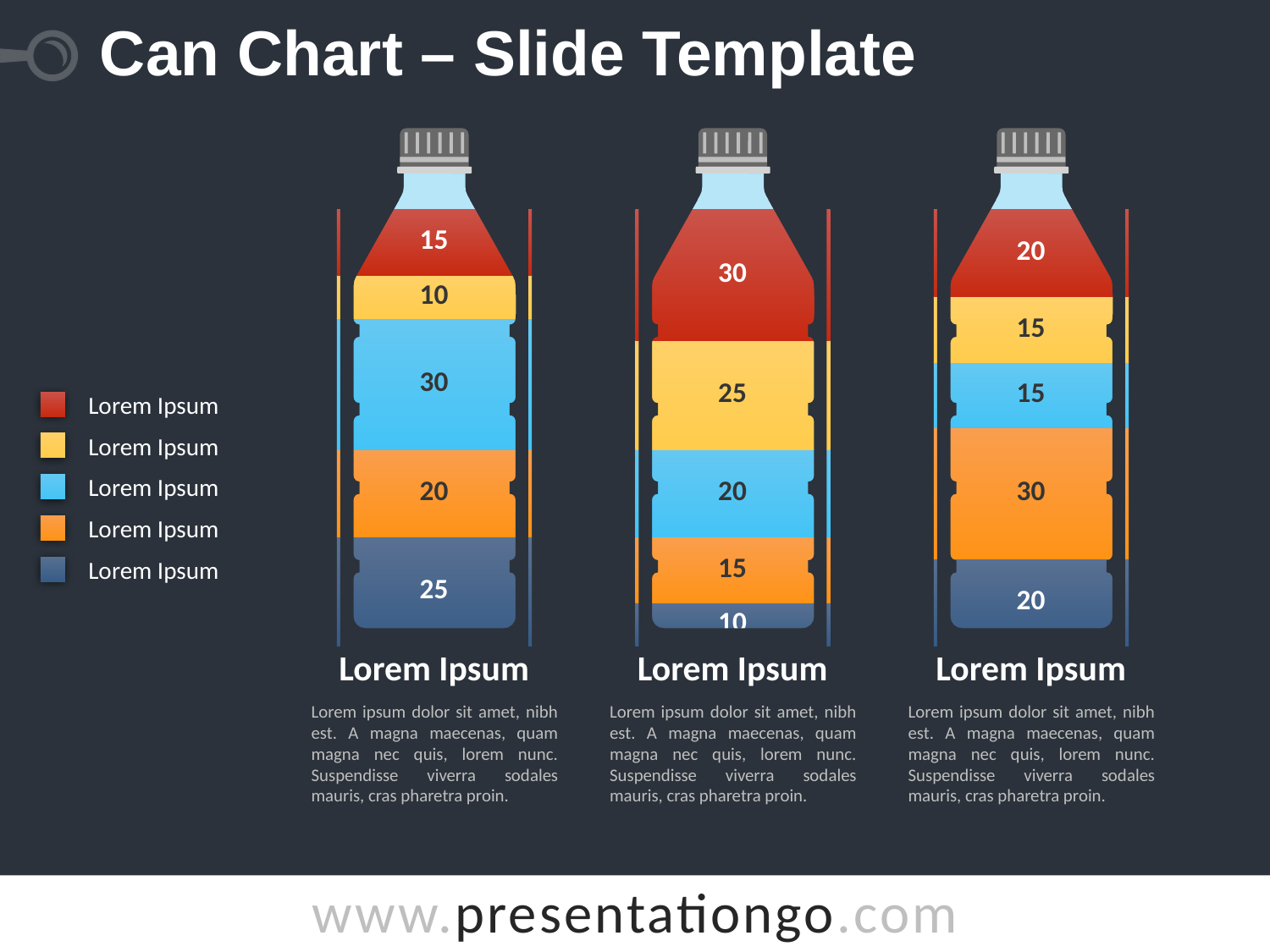
What is the total of all segments in the middle bottle? 100 How many bottle charts are shown on the slide? 3 In the middle bottle, what is the value of the yellow segment? 25 Which is larger: the red segment in the middle bottle or the red segment in the left bottle? The red segment in the middle bottle (30) In the left bottle, what is the value of the red segment at the top? 15 How many segments does each bottle contain? 5 In the right bottle, what is the difference between the orange segment and the yellow segment? 15 In the middle bottle, which segment has the smallest value? The dark blue segment (10) In the left bottle, what is the value of the dark blue segment at the bottom? 25 How many entries does the legend list? 5 In the left bottle, which segment has the largest value? The light blue segment (30) In the right bottle, what is the value of the orange segment? 30